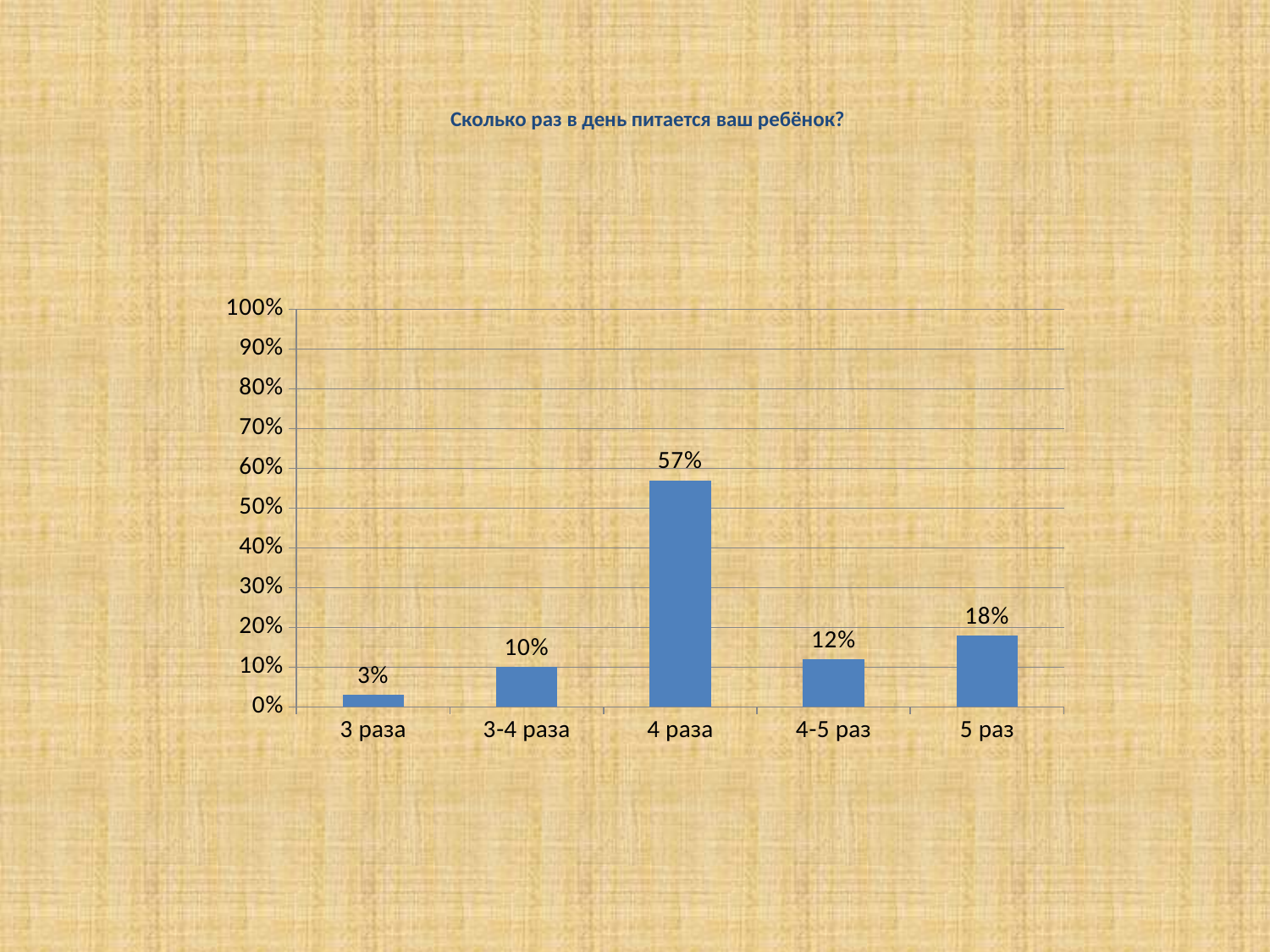
What is the difference between the values for "4 раза" and "5 раз"? 39% Which is larger, the value for "5 раз" or the value for "4-5 раз"? 5 раз What is the value for "4 раза"? 57% What is the title of the slide? Сколько раз в день питается ваш ребёнок? What is the value for "3 раза"? 3% Which category has the highest value? 4 раза What kind of chart is shown on the slide? bar chart Is the value for "4 раза" greater or less than 50%? greater What is the value for "5 раз"? 18% How many categories are shown on the x axis? 5 Which category has the lowest value? 3 раза What is the difference between the values for "4-5 раз" and "3-4 раза"? 2%